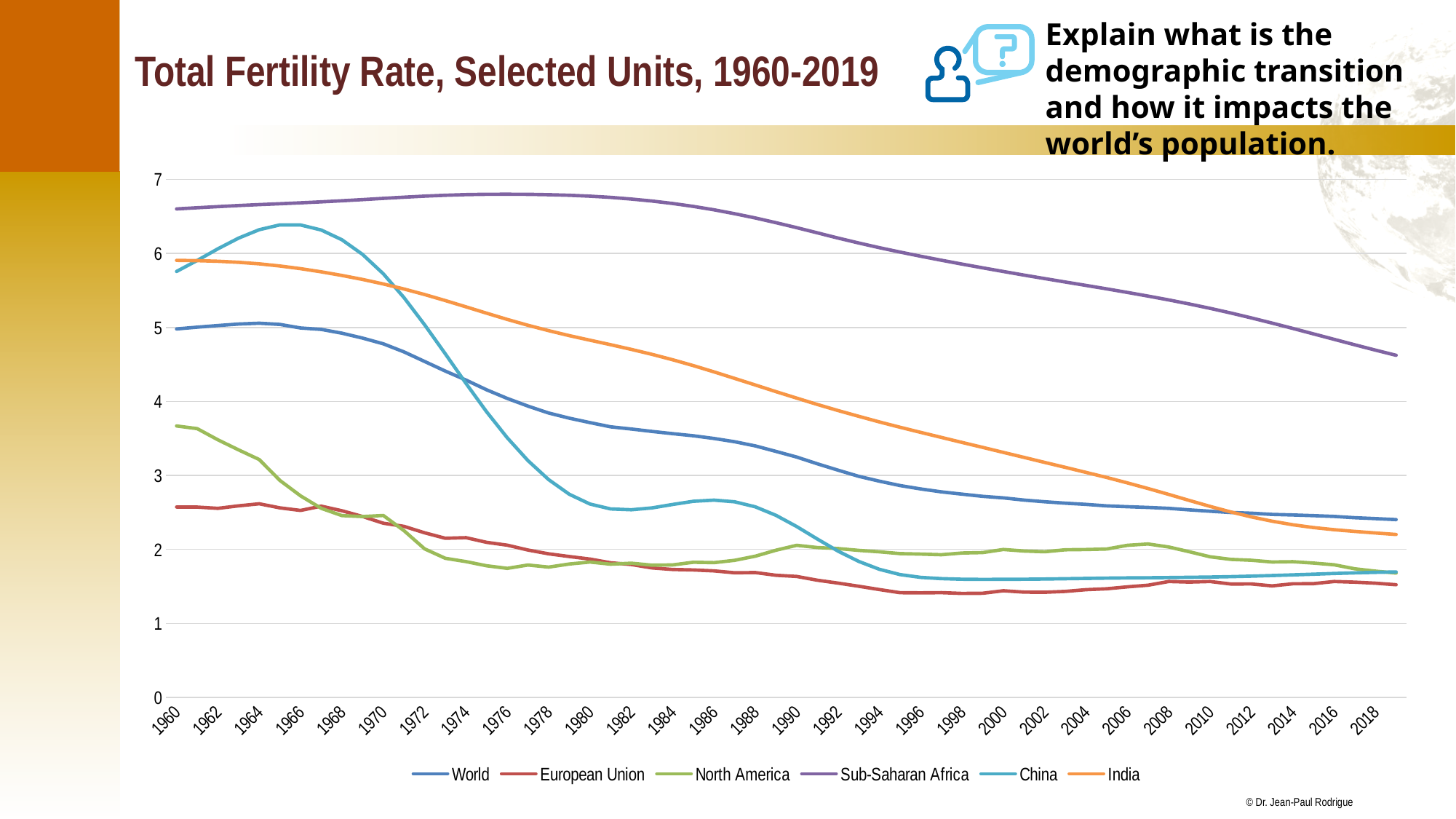
In 1966, which is higher: China or European Union? China Which series has the highest fertility rate in 1960? Sub-Saharan Africa How many series does the legend list? 6 Which series has the highest fertility rate in 2018? Sub-Saharan Africa Is the value for World in 2018 greater or less than 3? less Which series has the lowest fertility rate in 1960? European Union Is the value for China in 1960 greater or less than 5? greater In 1990, which is higher: India or World? India What kind of chart is shown on the slide? line chart What is the title of the chart? Total Fertility Rate, Selected Units, 1960-2019 Does the Sub-Saharan Africa line rise or fall between 1980 and 2018? fall Is the value for Sub-Saharan Africa in 2018 greater or less than 4? greater